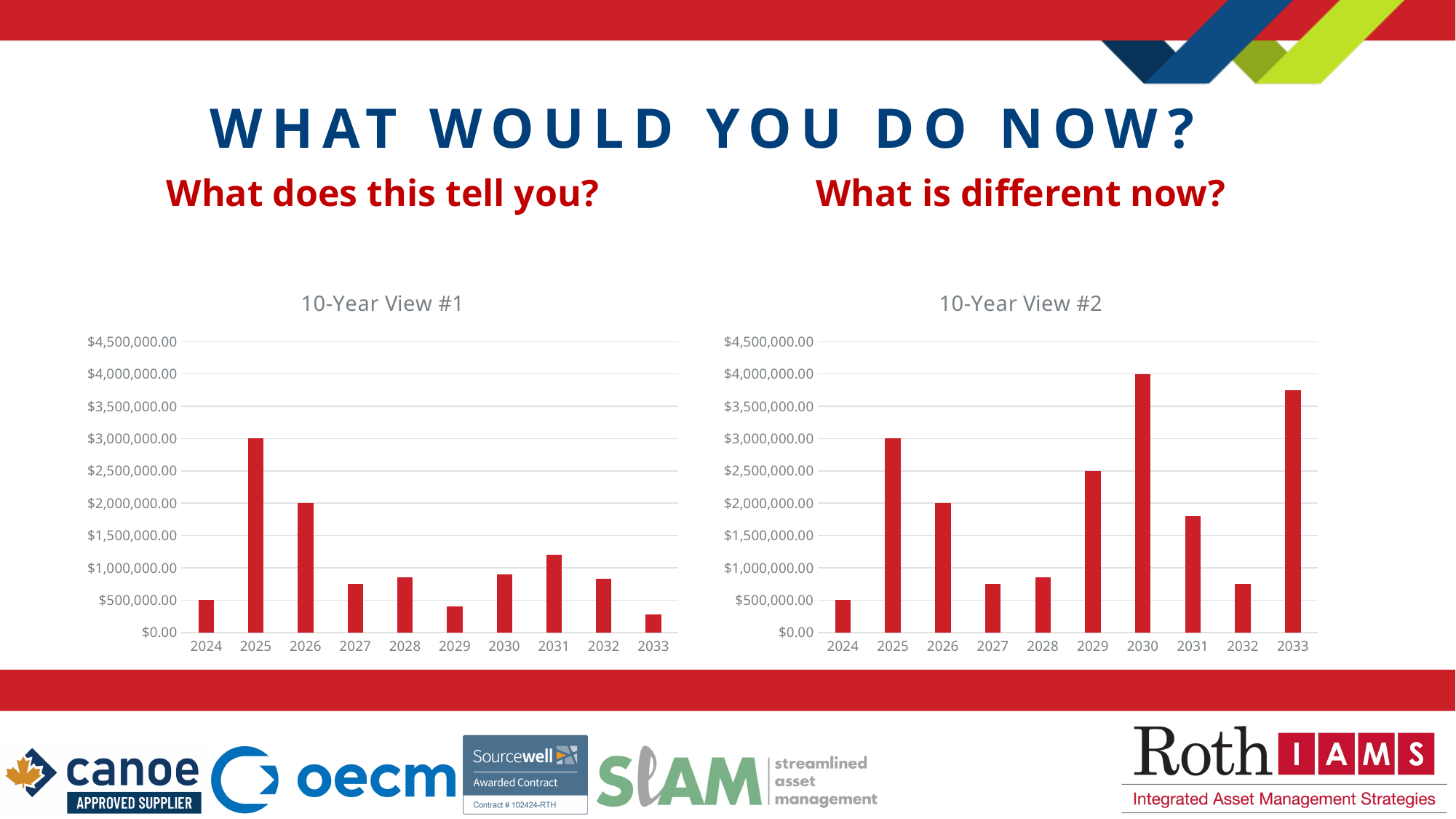
In the 10-Year View #2 chart, what is the value for 2030? $4,000,000.00 In the 10-Year View #2 chart, which year has the highest value? 2030 What kind of chart is 10-Year View #1? bar chart In the 10-Year View #1 chart, which is larger, the value for 2026 or the value for 2027? 2026 In the 10-Year View #1 chart, is the value for 2031 greater or less than $1,000,000.00? greater In the 10-Year View #2 chart, is the value for 2033 greater or less than $3,500,000.00? greater In the 10-Year View #1 chart, what is the value for 2025? $3,000,000.00 How many years are shown on the x axis of the 10-Year View #2 chart? 10 In the 10-Year View #2 chart, what is the difference between the values for 2030 and 2025? $1,000,000.00 In the 10-Year View #2 chart, what is the value for 2029? $2,500,000.00 In the 10-Year View #1 chart, which year has the highest value? 2025 In the 10-Year View #1 chart, which year has the lowest value? 2033